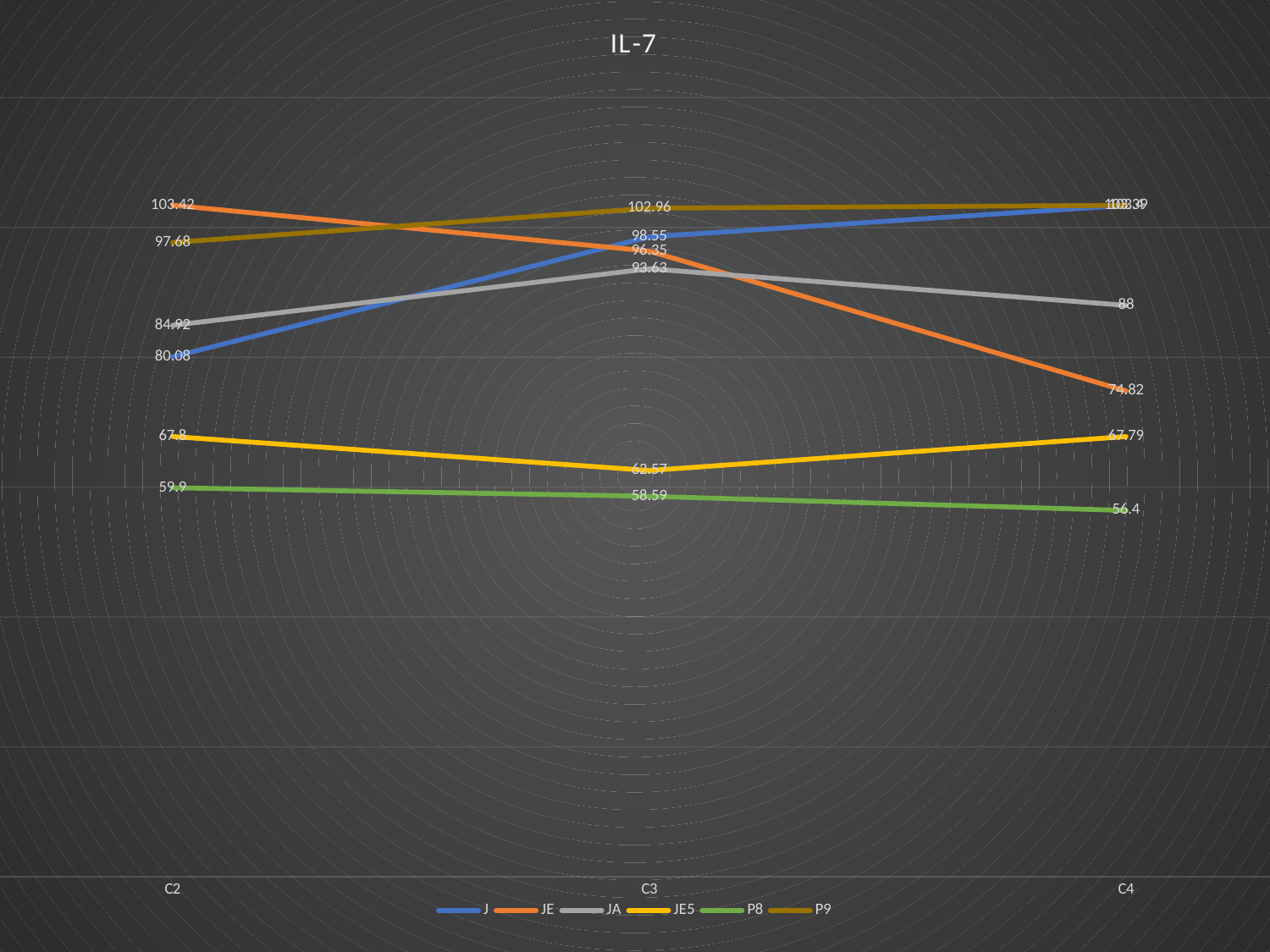
What type of chart is shown on the slide? line chart What is the title of the chart? IL-7 How many series does the legend list? 6 Which series has the highest value at C2? JE What is the value of P8 at C3? 58.59 What is the difference between the JE value at C2 and at C4? 28.6 How many categories are shown on the x axis? 3 Does the JE series rise or fall from C2 to C4? fall Which series has the lowest value at C3? P8 What is the value of JE at C2? 103.42 What is the value of JE5 at C3? 62.57 What is the value of JA at C4? 88